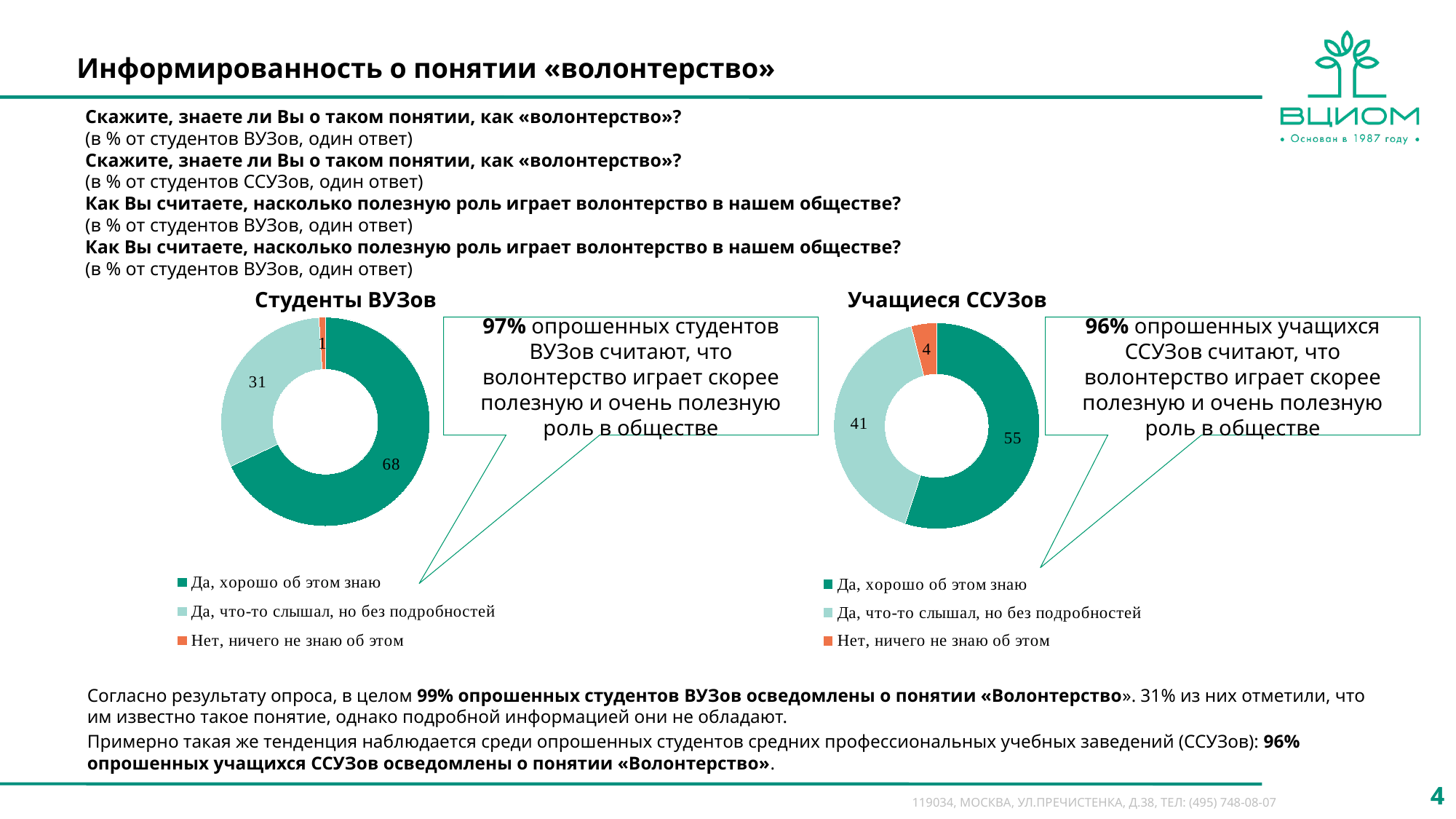
In the «Учащиеся ССУЗов» chart, what is the value for «Нет, ничего не знаю об этом»? 4 In the «Учащиеся ССУЗов» chart, what is the difference between «Да, хорошо об этом знаю» and «Да, что-то слышал, но без подробностей»? 14 In the «Учащиеся ССУЗов» chart, what is the value for «Да, хорошо об этом знаю»? 55 What type of chart is the «Студенты ВУЗов» chart? Donut (pie) chart In the «Студенты ВУЗов» chart, which category has the largest share? Да, хорошо об этом знаю In the «Учащиеся ССУЗов» chart, what colour is the «Нет, ничего не знаю об этом» slice? Orange In the «Учащиеся ССУЗов» chart, which category has the smallest share? Нет, ничего не знаю об этом Which is larger: «Да, хорошо об этом знаю» in the «Студенты ВУЗов» chart or in the «Учащиеся ССУЗов» chart? Студенты ВУЗов In the «Студенты ВУЗов» chart, what is the value for «Да, что-то слышал, но без подробностей»? 31 In the «Студенты ВУЗов» chart, what is the difference between «Да, что-то слышал, но без подробностей» and «Нет, ничего не знаю об этом»? 30 How many categories does the «Учащиеся ССУЗов» chart show? 3 In the «Студенты ВУЗов» chart, what is the value for «Да, хорошо об этом знаю»? 68